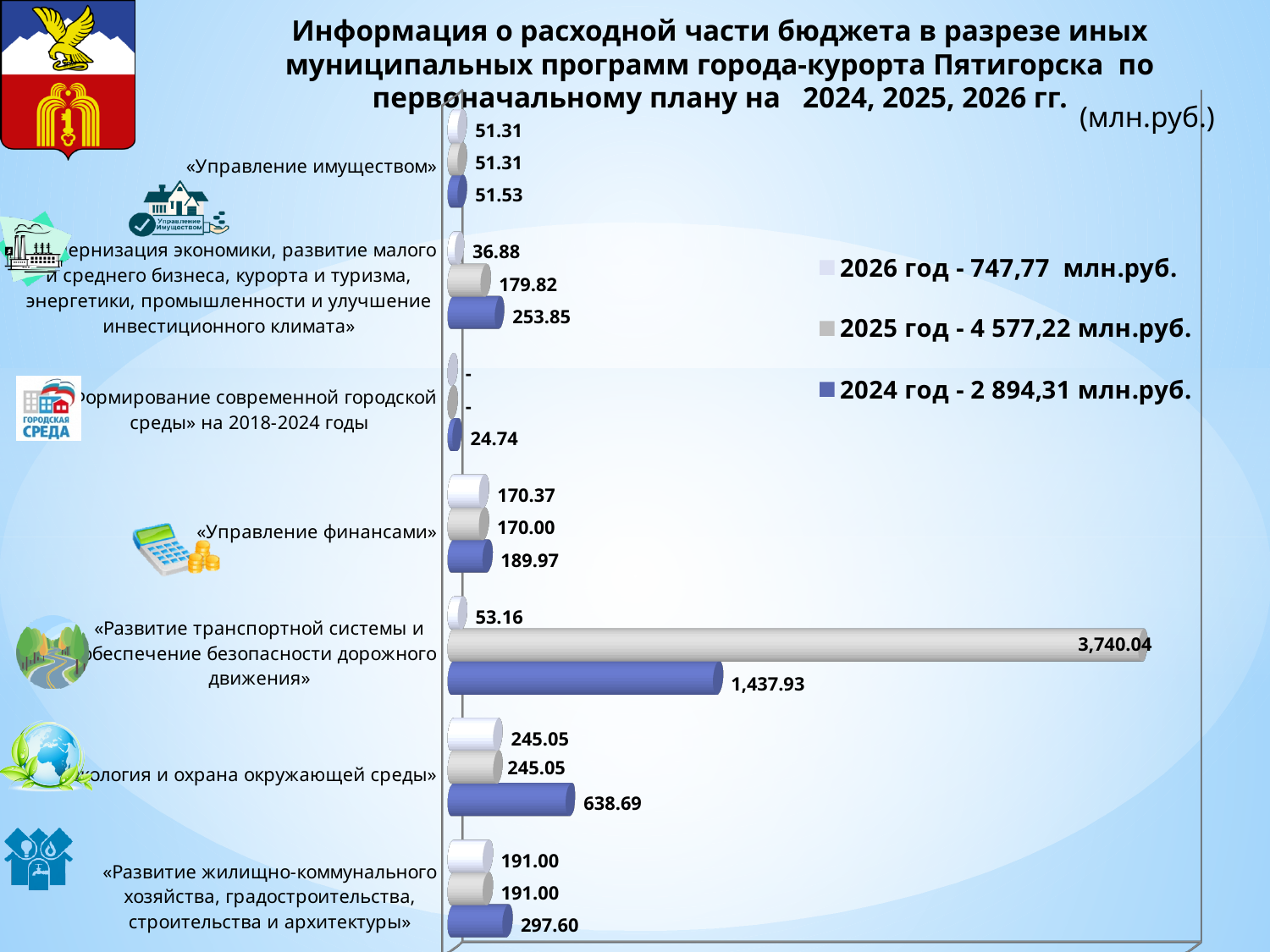
Which program has the lowest 2024 value? «Формирование современной городской среды» на 2018-2024 годы What is the 2024 value for «Экология и охрана окружающей среды»? 638.69 How many series does the legend list? 3 Which program has the highest 2025 value? «Развитие транспортной системы и обеспечение безопасности дорожного движения» What is the 2026 value for «Управление финансами»? 170.37 What is the 2025 value for «Развитие транспортной системы и обеспечение безопасности дорожного движения»? 3,740.04 Which is larger for «Модернизация экономики...»: the 2025 value or the 2024 value? 2024 value (253.85) What is the 2024 value for «Развитие транспортной системы и обеспечение безопасности дорожного движения»? 1,437.93 What kind of chart is shown on the slide? bar chart How many program categories are plotted on the chart? 7 According to the legend, what is the total for 2025 год? 4 577,22 млн.руб. What is the difference between the 2024 and 2026 values for «Экология и охрана окружающей среды»? 393.64